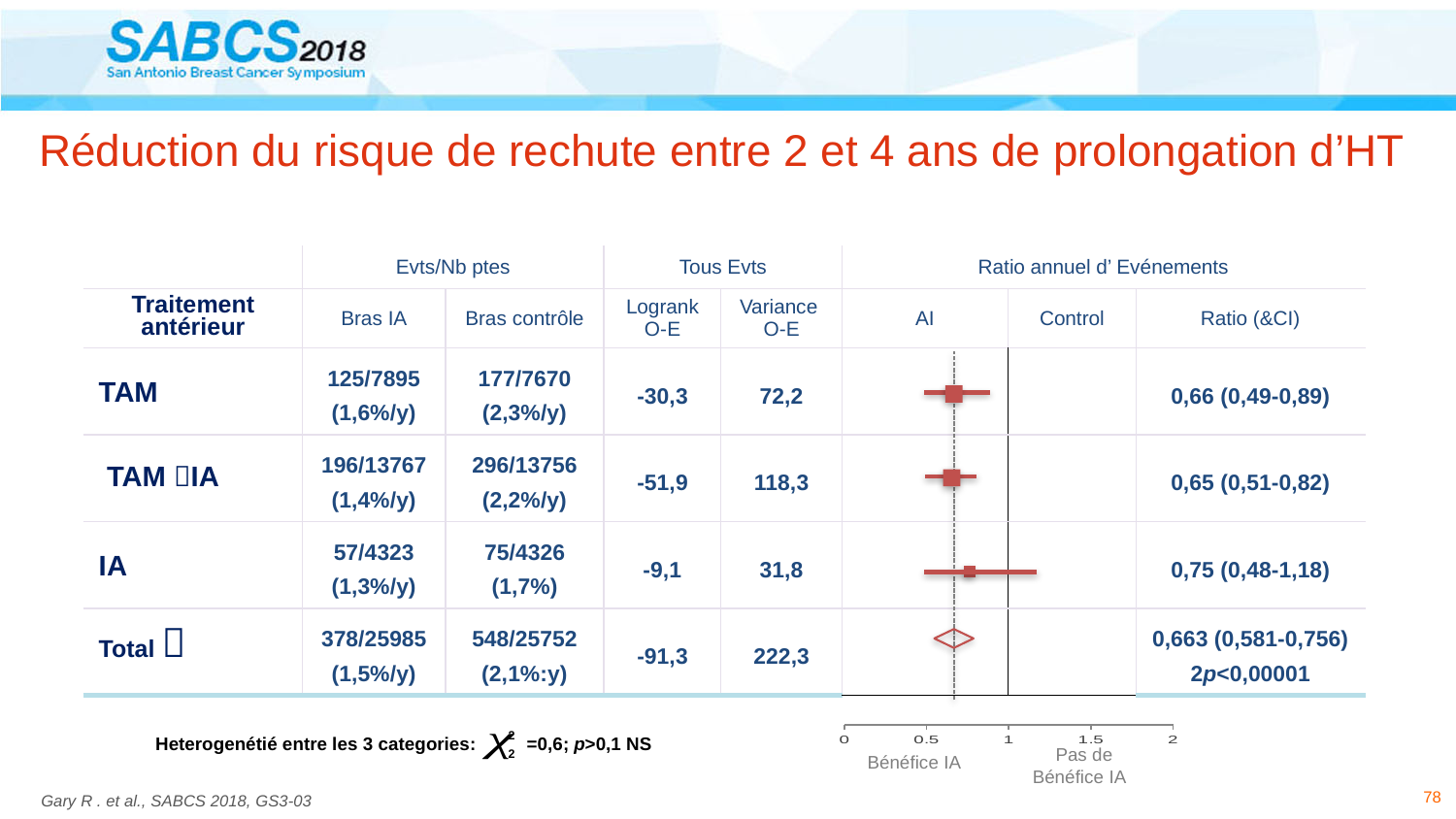
What is the highest tick value shown on the forest plot axis? 2 What is the difference between the ratio for IA and the ratio for TAM? 0,09 Is the ratio for TAM larger or smaller than the ratio for IA? smaller What is the ratio (with CI) plotted for the TAM row in the forest plot? 0,66 (0,49-0,89) What label appears under the left side of the forest plot axis (below 0.5)? Bénéfice IA What kind of chart is shown in the Ratio annuel d'Evénements column? forest plot Which prior treatment category has the highest annual event ratio in the forest plot? IA How many prior treatment categories (excluding Total) are plotted in the forest plot? 3 What is the ratio (with CI) plotted for the Total row in the forest plot? 0,663 (0,581-0,756) Is the plotted ratio for TAM→IA greater or less than 1? less Is the plotted ratio for TAM greater or less than 1? less What is the ratio (with CI) plotted for the IA row in the forest plot? 0,75 (0,48-1,18)